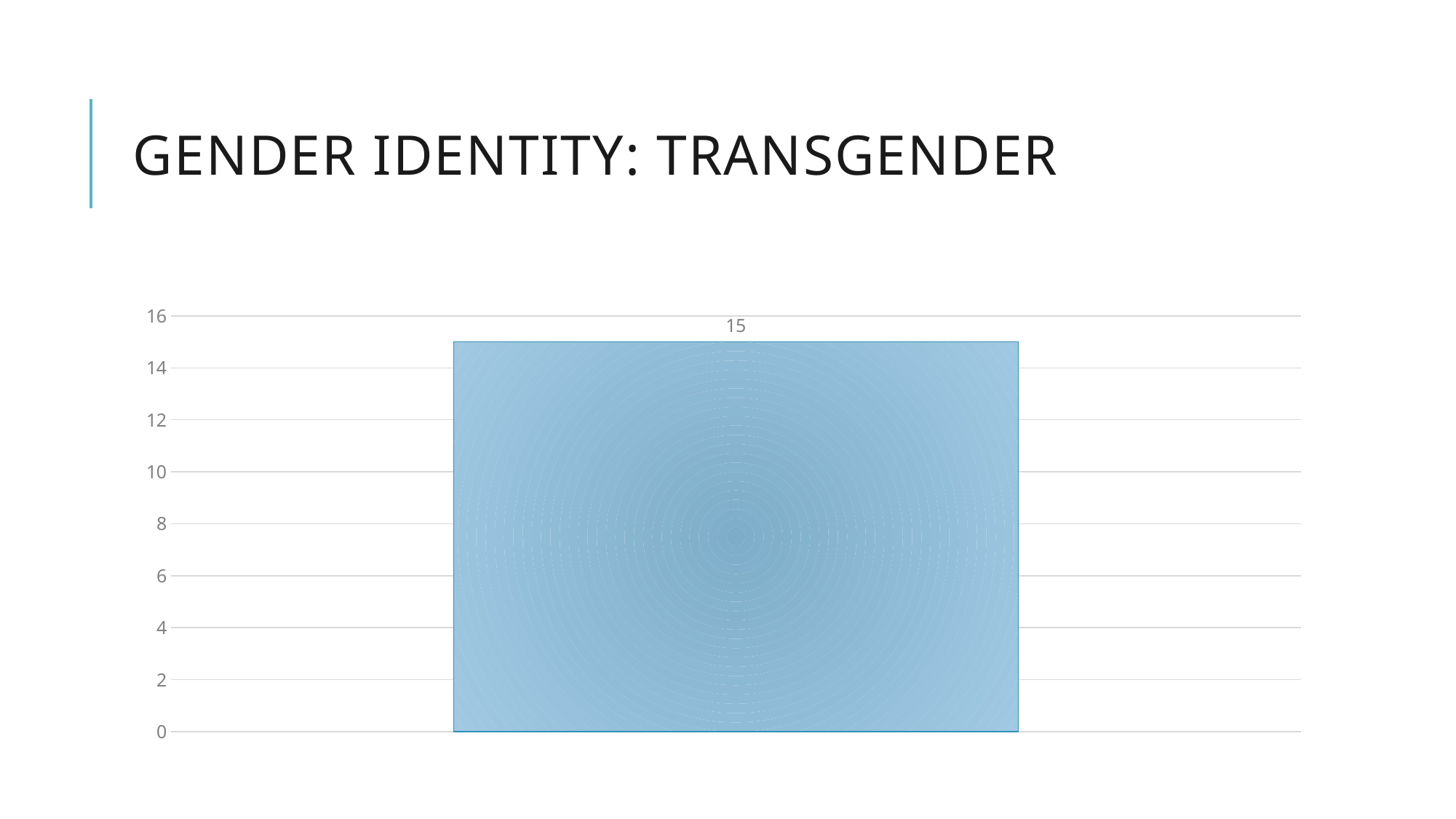
What value is shown by the single bar on the chart? 15 What kind of chart is shown on the slide? bar chart What is the highest value shown on the vertical axis? 16 How many bars are plotted on the chart? 1 What is the title of the slide containing the chart? GENDER IDENTITY: TRANSGENDER Is the value of the bar greater or less than 16? less Is the value of the bar greater or less than 10? greater